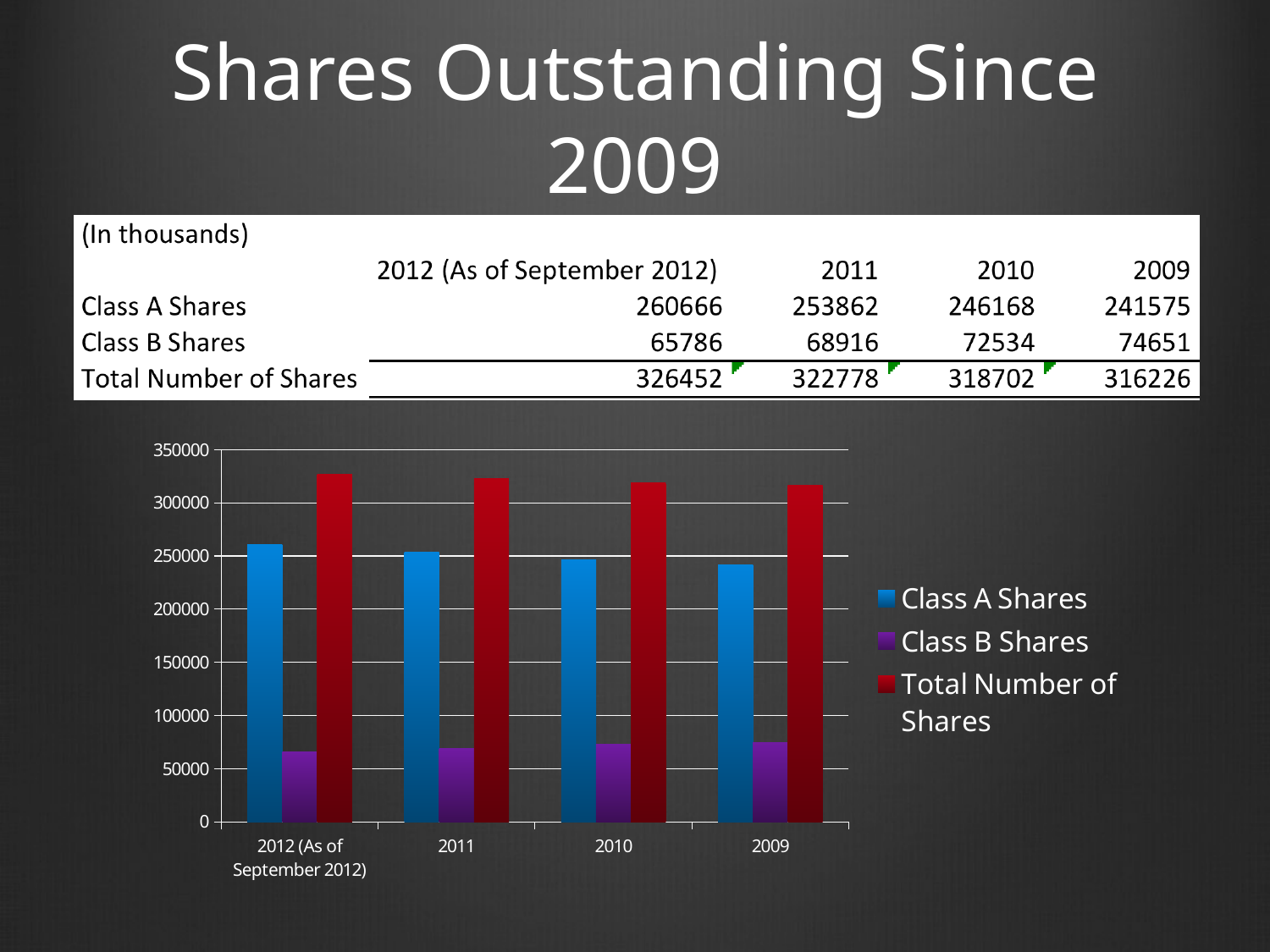
In which year is the Class B Shares value lowest? 2012 (As of September 2012) What is the value of Class B Shares for 2009? 74651 What is the value of Class A Shares for 2011? 253862 What is the difference between Class A Shares in 2012 (As of September 2012) and in 2009? 19091 How many series does the chart's legend list? 3 Which is larger: Class B Shares in 2010 or Class B Shares in 2011? Class B Shares in 2010 Is the value for Class B Shares in 2011 greater or less than 100000? less What kind of chart is shown on the slide? bar chart Do the Class A Shares values rise or fall from 2012 (As of September 2012) to 2009 along the x axis? fall In which year is the Total Number of Shares highest? 2012 (As of September 2012) How many year categories are shown on the x axis of the chart? 4 What is the Total Number of Shares for 2012 (As of September 2012)? 326452